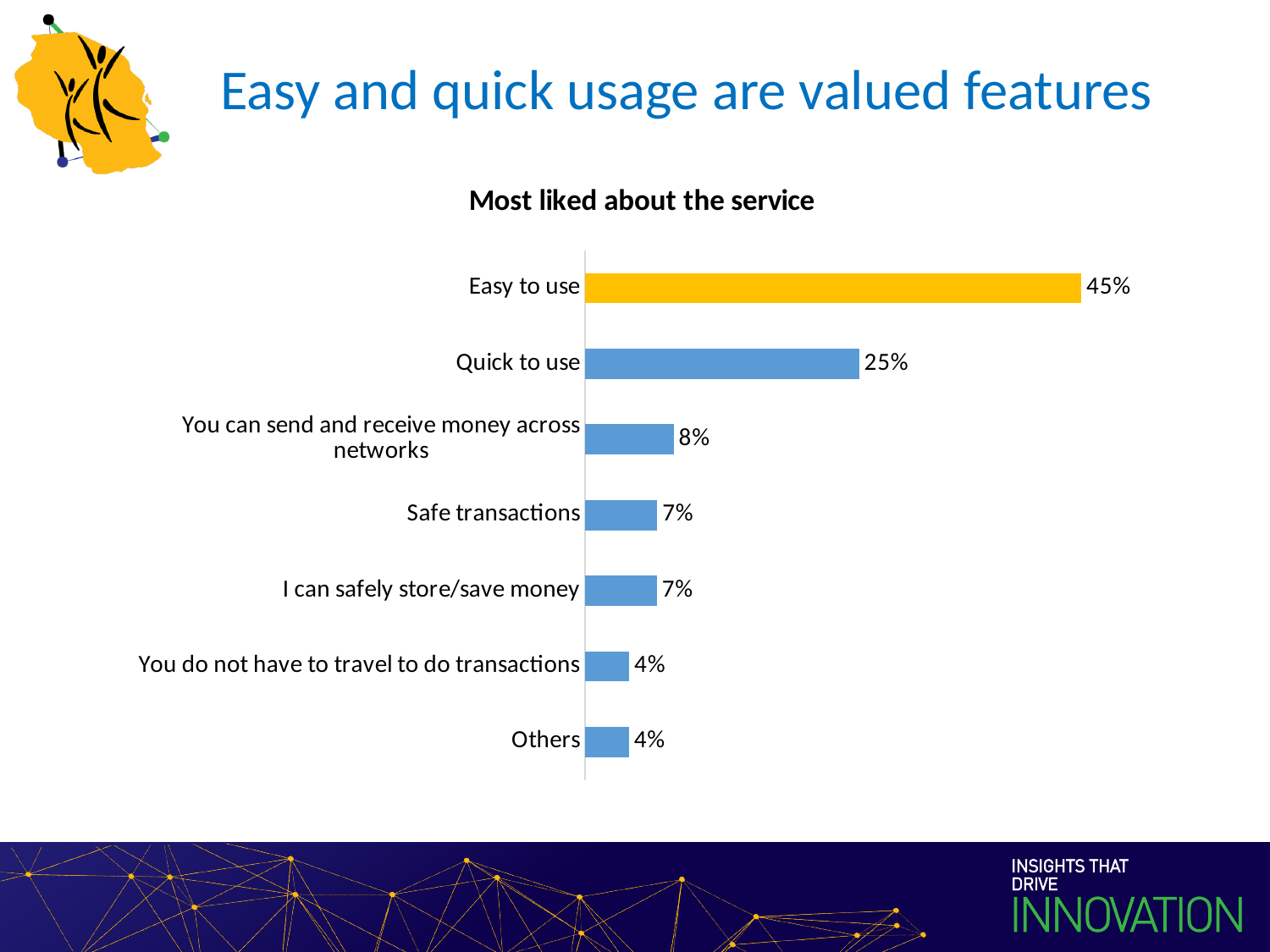
Which bar is coloured differently (yellow) from the others? Easy to use Which category has the highest value? Easy to use What is the title of the chart? Most liked about the service What is the value for 'You can send and receive money across networks'? 8% What is the value for 'Quick to use'? 25% What is the value for 'You do not have to travel to do transactions'? 4% What percentage of respondents said the service is easy to use? 45% How many categories are shown in the chart? 7 What is the difference between 'Quick to use' and 'Safe transactions'? 18% What kind of chart is shown on the slide? Bar chart Which is larger, 'Quick to use' or 'I can safely store/save money'? Quick to use What is the difference between 'Easy to use' and 'Quick to use'? 20%